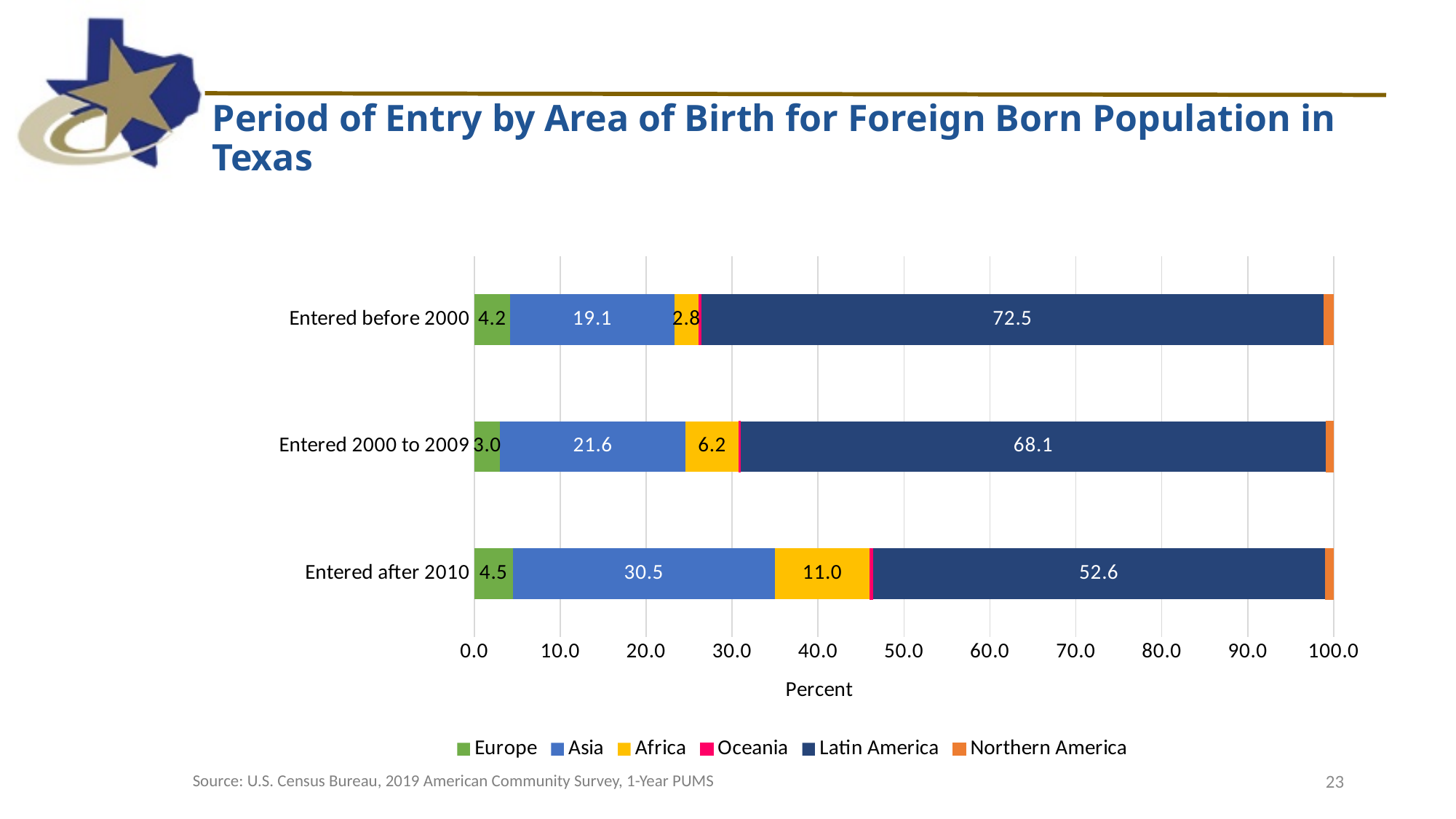
Which is larger, the Latin America value for Entered 2000 to 2009 or for Entered after 2010? Entered 2000 to 2009 What is the Asia value for Entered after 2010? 30.5 What kind of chart is shown on the slide? Stacked bar chart How many series does the legend list? 6 What is the Europe value for Entered 2000 to 2009? 3.0 What is the Latin America value for Entered before 2000? 72.5 What is the difference between the Asia values for Entered after 2010 and Entered before 2000? 11.4 Which period of entry has the highest Latin America value? Entered before 2000 Which period of entry has the lowest Africa value? Entered before 2000 What is the label of the x axis? Percent What is the Africa value for Entered 2000 to 2009? 6.2 How many periods of entry are shown on the chart? 3